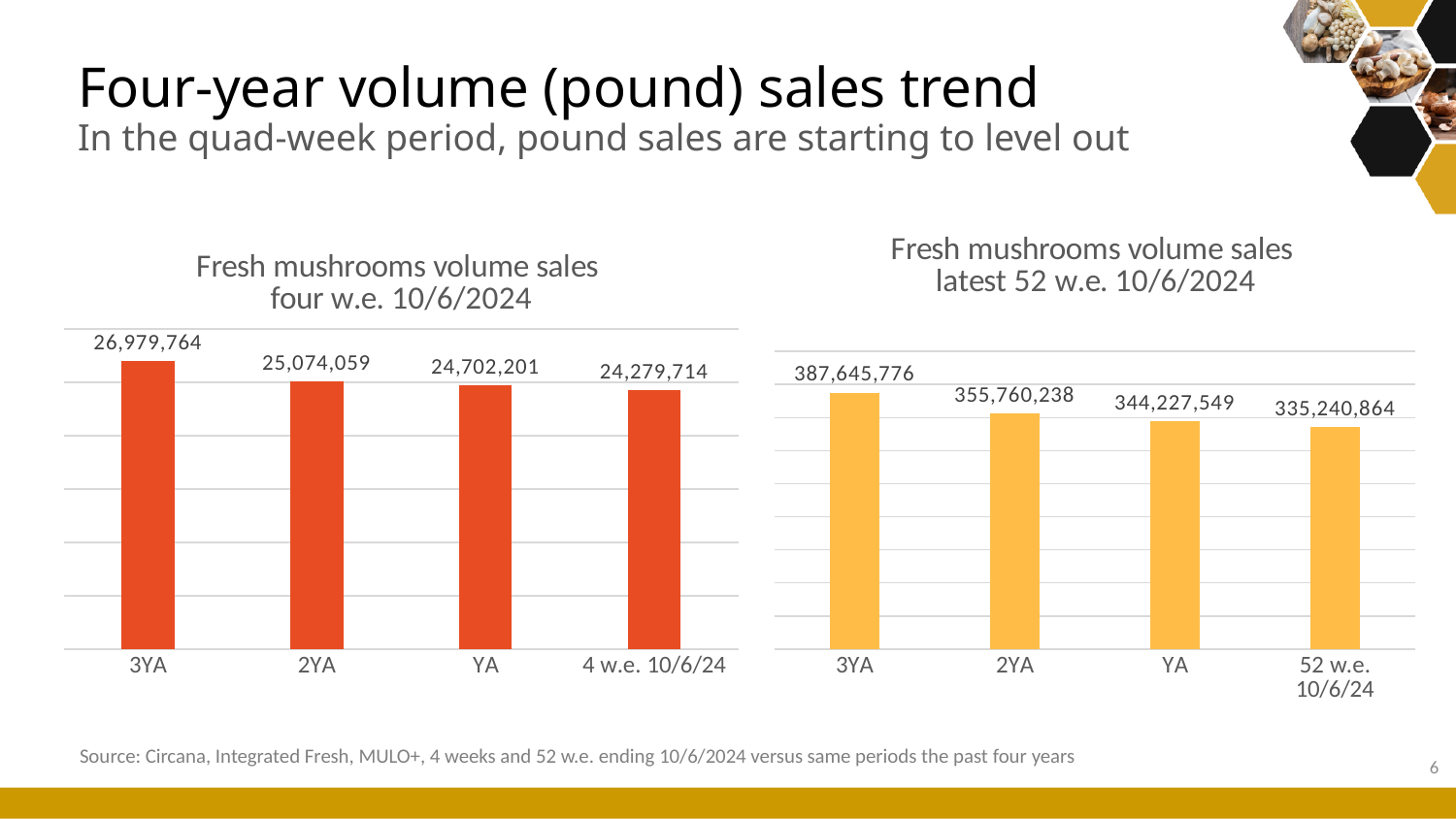
In the 'Fresh mushrooms volume sales latest 52 w.e. 10/6/2024' chart, what is the value for 52 w.e. 10/6/24? 335,240,864 In the 'Fresh mushrooms volume sales latest 52 w.e. 10/6/2024' chart, which is larger, the value for YA or the value for 2YA? 2YA In the 'Fresh mushrooms volume sales four w.e. 10/6/2024' chart, what is the value for 3YA? 26,979,764 What kind of chart is the 'Fresh mushrooms volume sales latest 52 w.e. 10/6/2024' chart? Bar chart In the 'Fresh mushrooms volume sales four w.e. 10/6/2024' chart, which category has the highest value? 3YA In the 'Fresh mushrooms volume sales four w.e. 10/6/2024' chart, what is the value for 4 w.e. 10/6/24? 24,279,714 In the 'Fresh mushrooms volume sales latest 52 w.e. 10/6/2024' chart, what is the difference between the 3YA value and the 2YA value? 31,885,538 In the 'Fresh mushrooms volume sales four w.e. 10/6/2024' chart, do the values rise or fall from 3YA to 4 w.e. 10/6/24? Fall In the 'Fresh mushrooms volume sales four w.e. 10/6/2024' chart, what is the difference between the 3YA value and the 4 w.e. 10/6/24 value? 2,700,050 How many categories are shown in the 'Fresh mushrooms volume sales four w.e. 10/6/2024' chart? 4 In the 'Fresh mushrooms volume sales latest 52 w.e. 10/6/2024' chart, which category has the lowest value? 52 w.e. 10/6/24 In the 'Fresh mushrooms volume sales latest 52 w.e. 10/6/2024' chart, what is the value for 2YA? 355,760,238